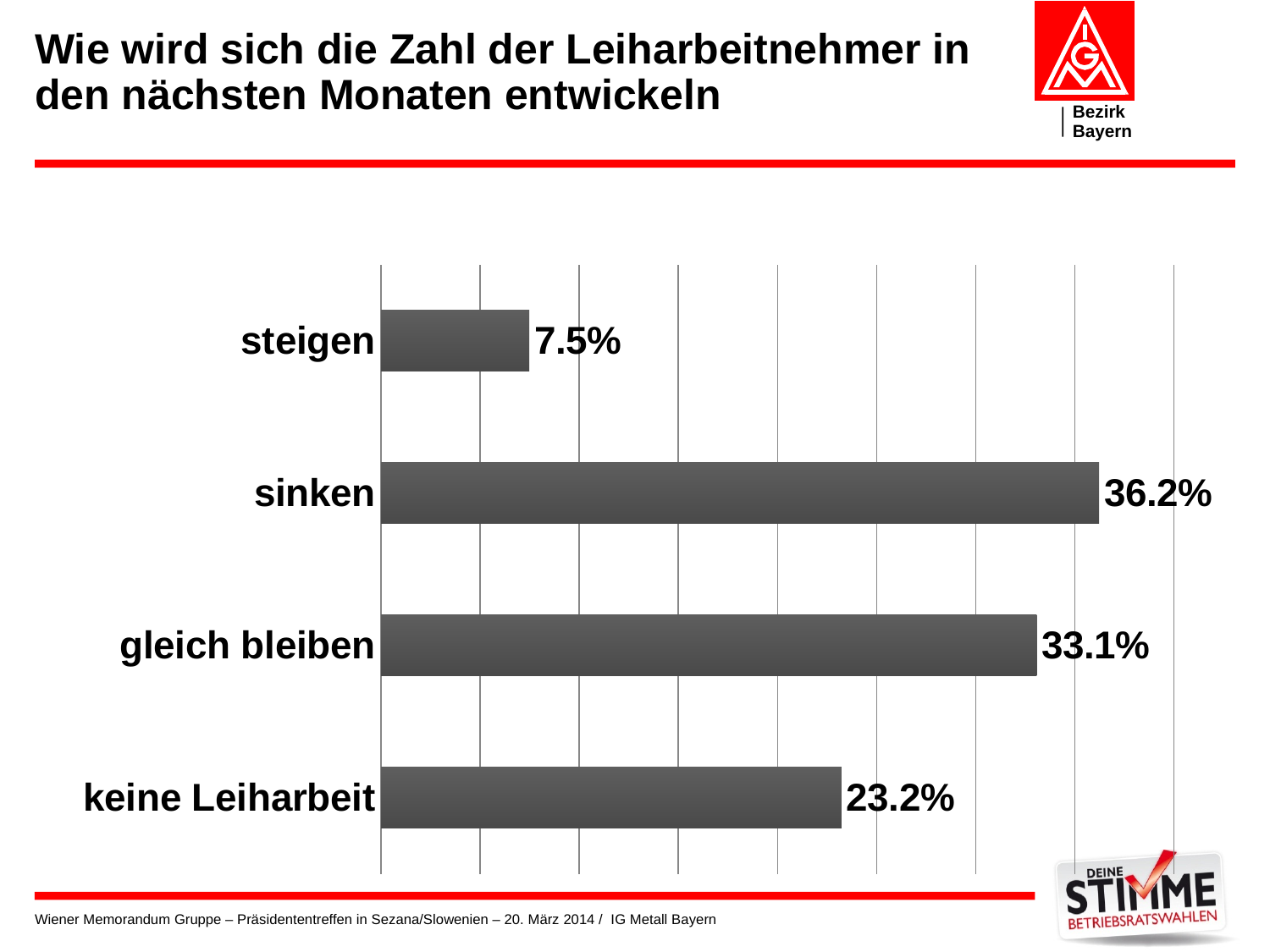
Which is larger, the value for "gleich bleiben" or the value for "keine Leiharbeit"? gleich bleiben What is the difference between the values for "sinken" and "gleich bleiben"? 3.1% What is the value for "steigen"? 7.5% What kind of chart is shown on the slide? bar chart Which category has the lowest value? steigen What is the value for "sinken"? 36.2% What is the value for "gleich bleiben"? 33.1% What is the difference between the values for "keine Leiharbeit" and "steigen"? 15.7% How many categories are shown in the chart? 4 What is the value for "keine Leiharbeit"? 23.2% What is the title of the slide containing the chart? Wie wird sich die Zahl der Leiharbeitnehmer in den nächsten Monaten entwickeln Which category has the highest value? sinken